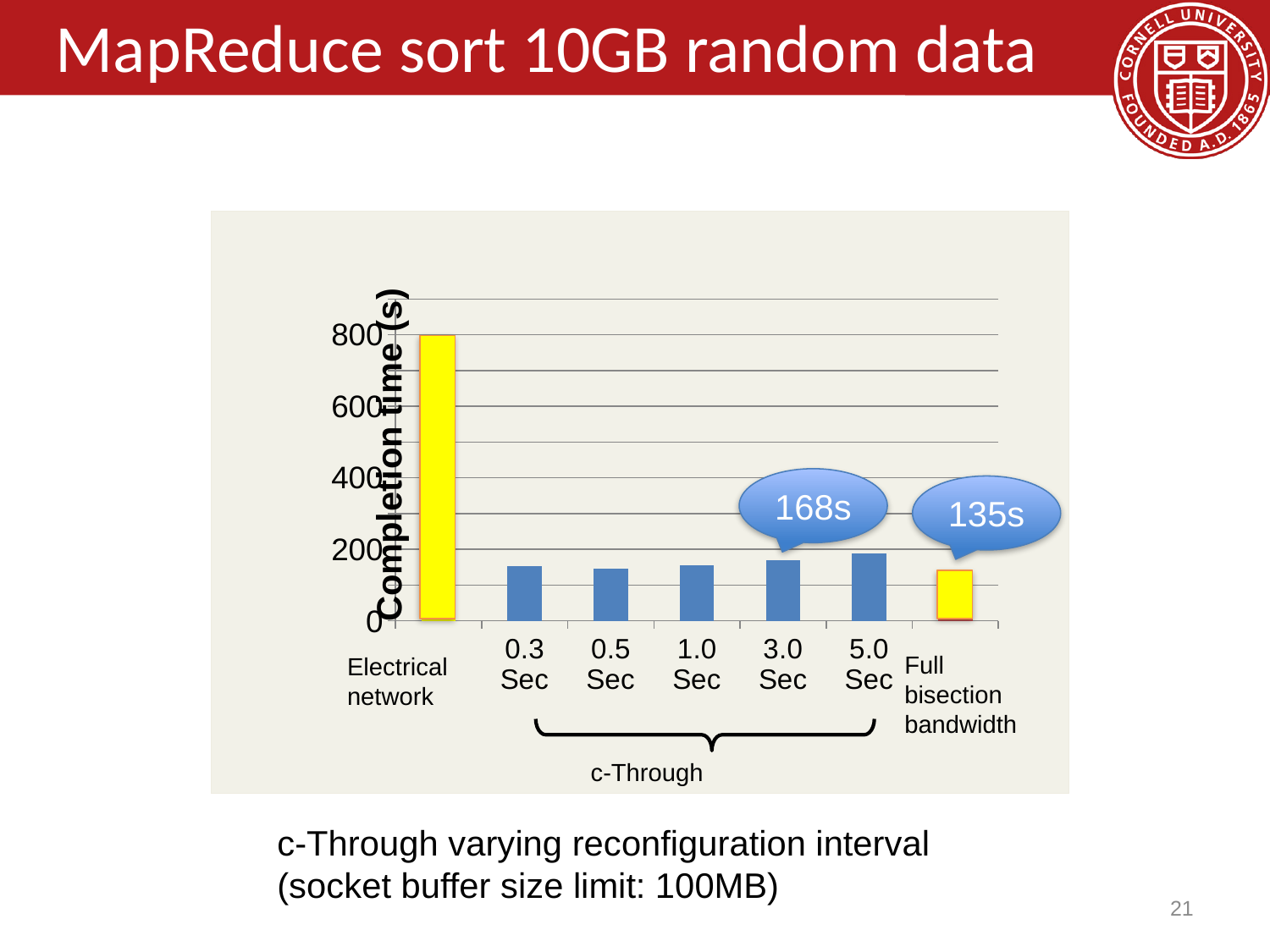
Which category has the highest completion time? Electrical network What kind of chart is shown on the slide? Bar chart Which group of bars does the bracket labelled c-Through span? 0.3 Sec through 5.0 Sec Is the completion time for 0.3 Sec greater or less than 200? less Which has the larger completion time, 5.0 Sec or 0.3 Sec? 5.0 Sec Which has the larger completion time, Electrical network or 5.0 Sec? Electrical network Is the completion time for Electrical network greater or less than 600? greater Do the completion times rise or fall going from 1.0 Sec to 5.0 Sec? rise How many bars (categories) are plotted in the chart? 7 What is the label on the vertical axis of the chart? Completion time (s) What completion time does the callout give for the Full bisection bandwidth bar? 135s Is the completion time for 5.0 Sec greater or less than 400? less